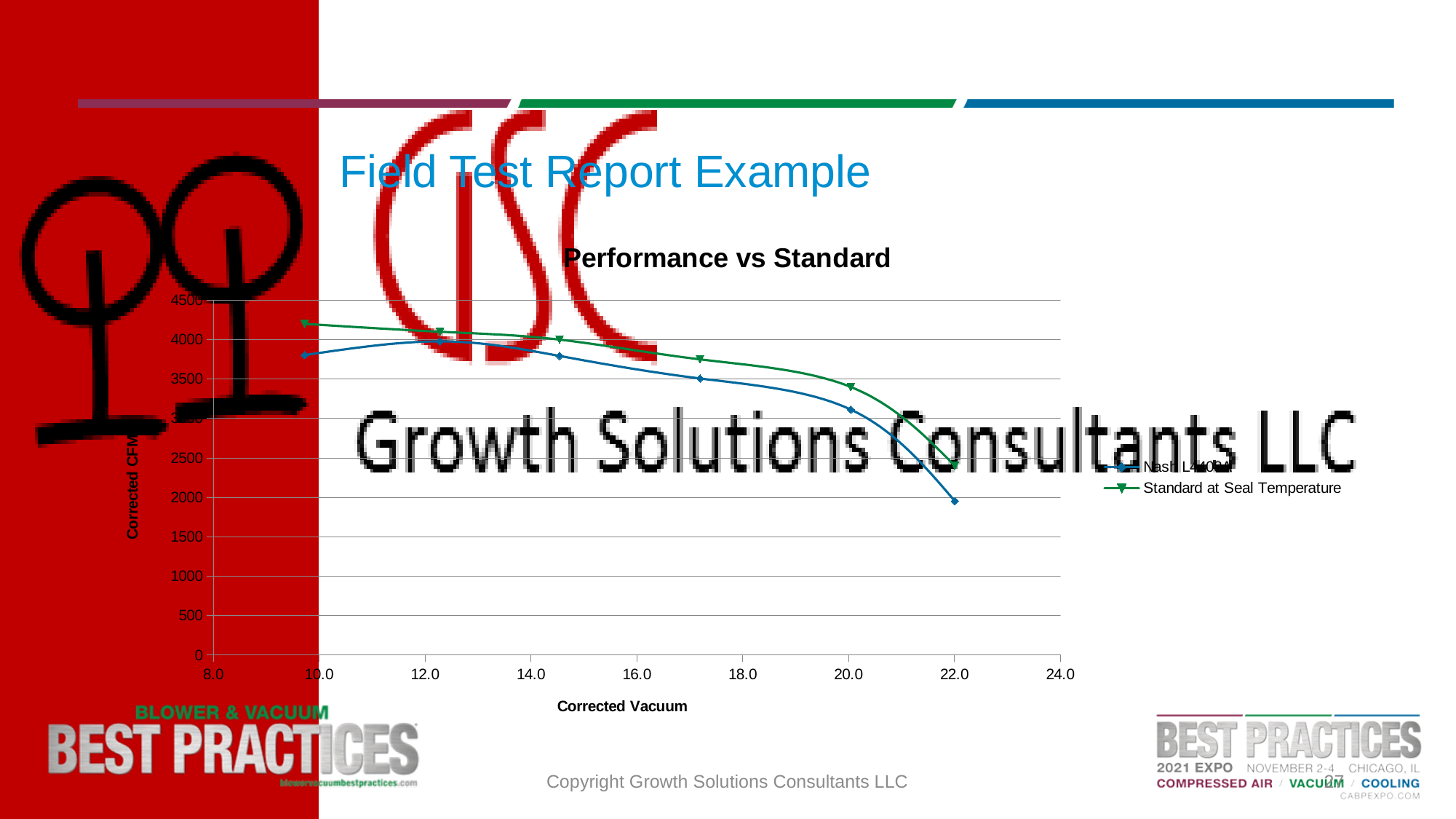
At a Corrected Vacuum of 22.0, which series has the higher Corrected CFM: the blue series or "Standard at Seal Temperature"? Standard at Seal Temperature How many data points are plotted for the "Standard at Seal Temperature" series? 6 Does the "Standard at Seal Temperature" series rise or fall as Corrected Vacuum increases? fall How many series does the legend of the "Performance vs Standard" chart list? 2 Is the value of the "Standard at Seal Temperature" series at its leftmost point (near 10.0) greater or less than 4000? greater What is the title of the chart on the slide? Performance vs Standard Is the value of the blue series at its leftmost point (near 10.0) greater or less than 4000? less What kind of chart is shown under the title "Performance vs Standard"? line chart Is the value of the blue series at a Corrected Vacuum of 22.0 greater or less than 2500? less What is the label of the x axis of the "Performance vs Standard" chart? Corrected Vacuum At which Corrected Vacuum value does the "Standard at Seal Temperature" series reach its lowest Corrected CFM? 22.0